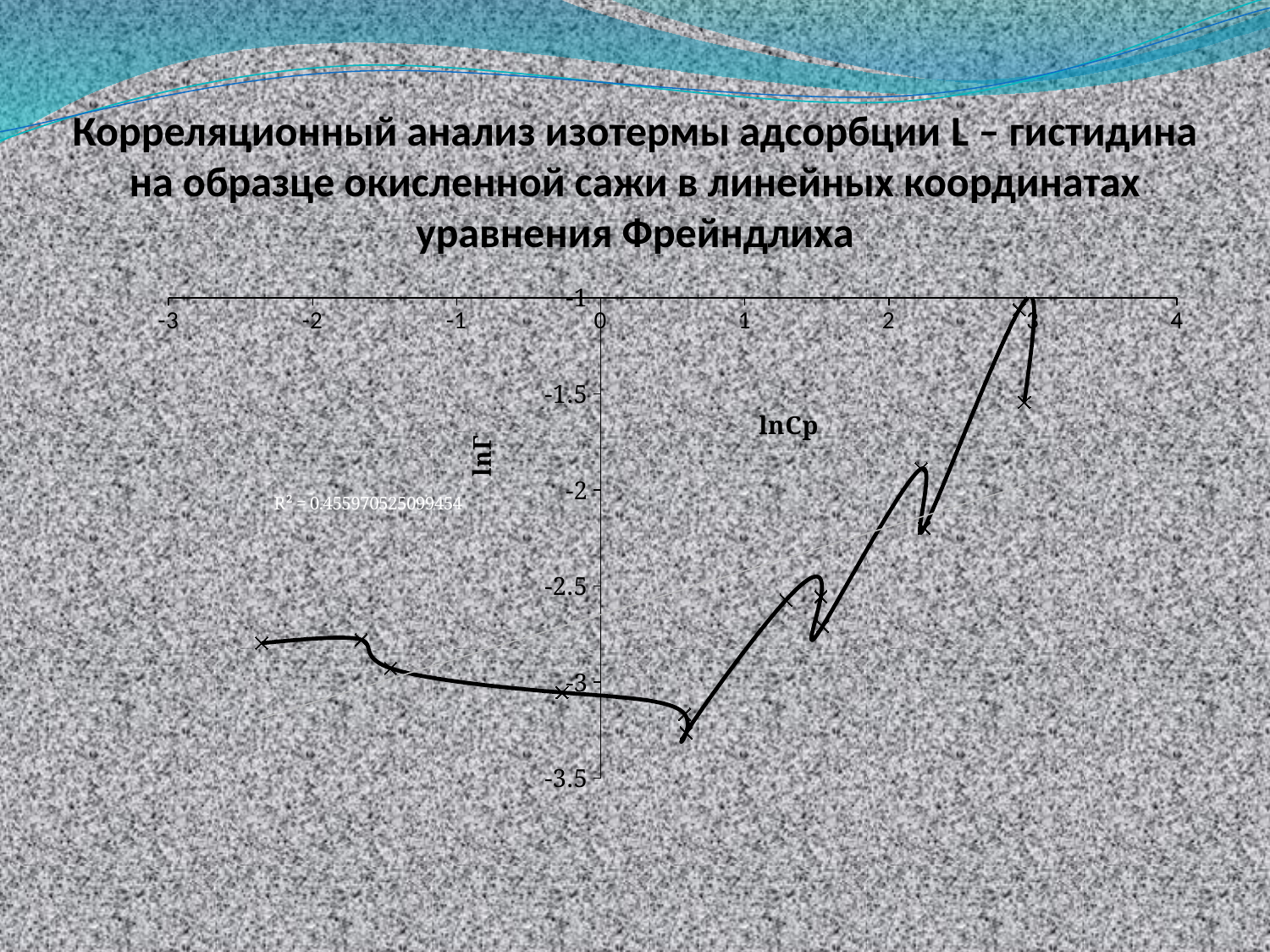
What is the label of the horizontal axis of the chart? lnCp Which has the larger lnГ value: the data point near lnCp = -2.3 or the data point near lnCp = 0.6? the data point near lnCp = -2.3 Is the lnГ value of the lowest data point (near lnCp = 0.6) greater or less than -3? less What kind of chart is shown on the slide? line chart (scatter with smoothed lines) Between lnCp = 1 and lnCp = 3, do the lnГ values generally rise or fall as lnCp increases? rise What is the R² value printed on the chart? R² = 0.455970525099454 Is the lnГ value of the leftmost data point (near lnCp = -2.3) greater or less than -3? greater Which has the larger lnГ value: the leftmost data point or the rightmost data point? the rightmost data point Between lnCp = -2 and lnCp = 0.5, do the lnГ values generally rise or fall as lnCp increases? fall Is the highest lnГ point on the chart located on the left or the right side of the plot? right Is the lowest lnГ point on the chart located to the left or to the right of lnCp = 0? right Is the lnГ value of the highest data point (near lnCp = 3) greater or less than -1.5? greater